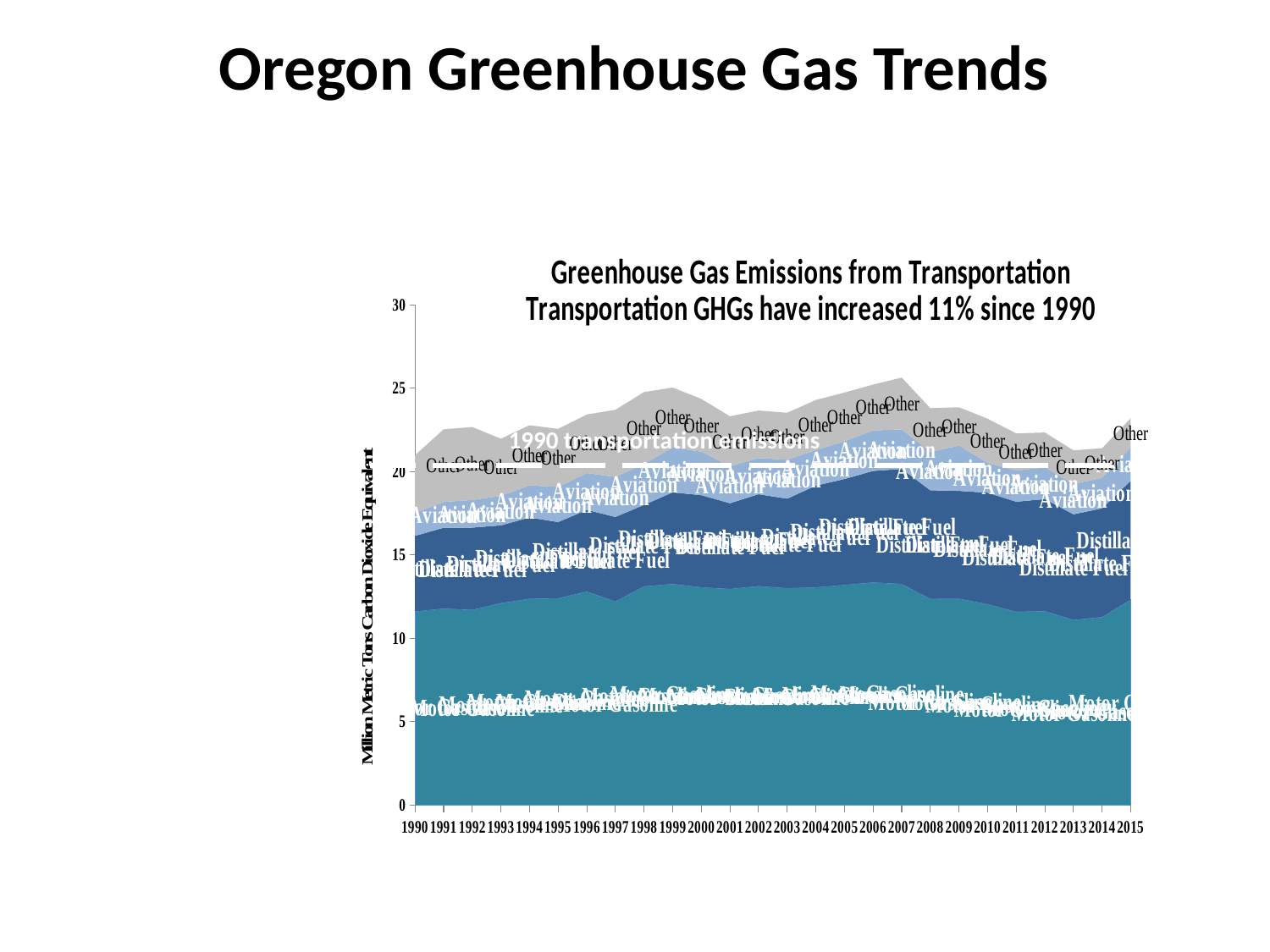
What is the last year shown on the x axis? 2015 What is the unit shown on the y axis of the chart? Million Metric Tons Carbon Dioxide Equivalent What is the first year shown on the x axis? 1990 Is the total transportation emissions value for 1990 greater or less than 20? greater Which series forms the bottom (largest) layer of the stacked area chart? Motor Gasoline Is the Motor Gasoline value for 2007 greater or less than 15? less Is the Motor Gasoline value for 1990 greater or less than 10? greater What kind of chart is shown on the slide? Stacked area chart What is the title of the chart? Greenhouse Gas Emissions from Transportation According to the chart's subtitle, by what percentage have transportation GHGs increased since 1990? 11% How many years are shown along the x axis of the chart? 26